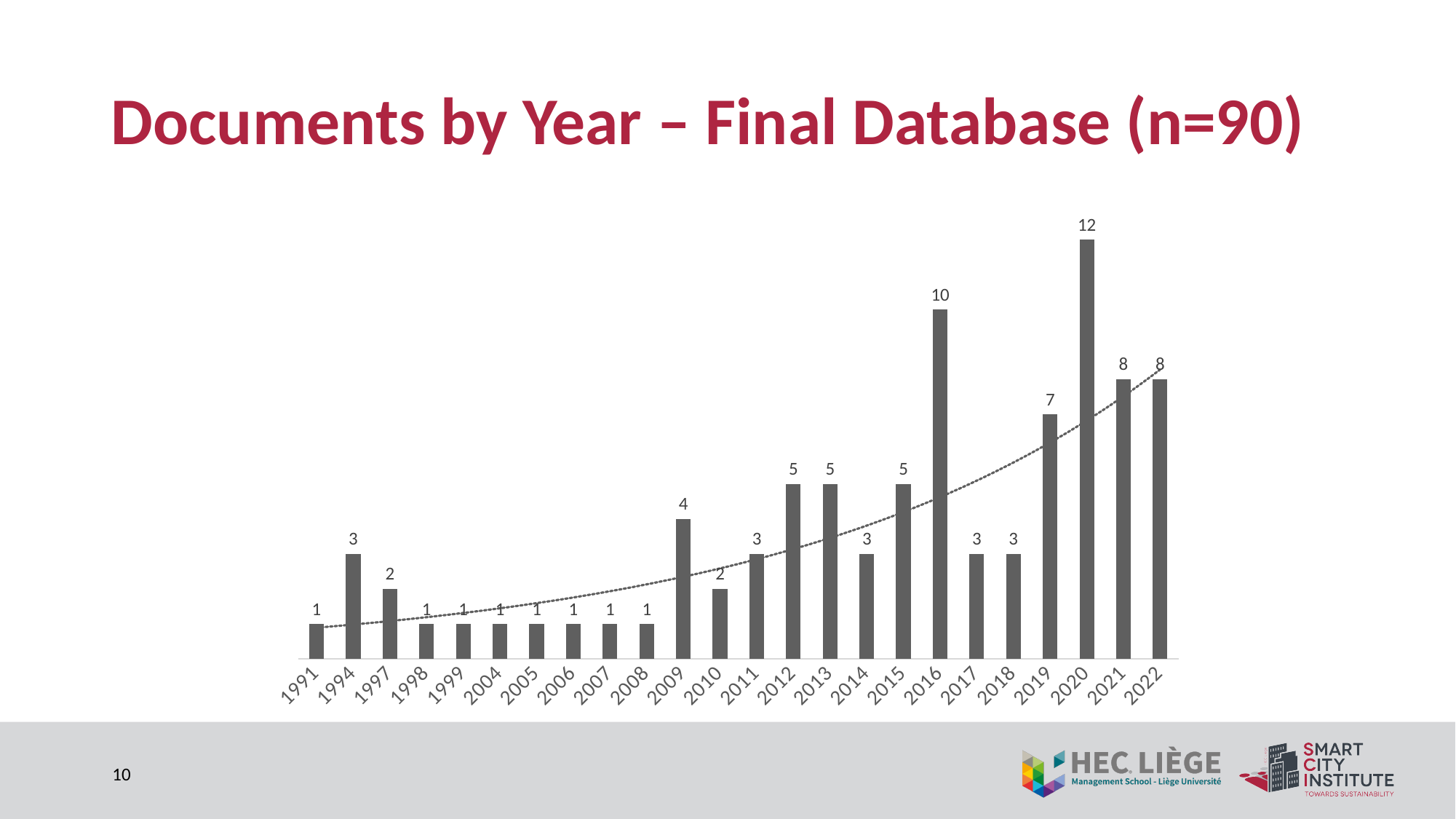
How many documents are shown for 2009? 4 How many years are shown on the x axis? 24 What is the value for 2019? 7 Which is larger, the value for 2012 or the value for 2014? 2012 What is the title of the slide? Documents by Year – Final Database (n=90) How many documents are shown for 2020? 12 What is the lowest value shown on the chart? 1 What is the difference between the values for 2019 and 2018? 4 What is the difference between the values for 2020 and 2016? 2 What is the value for 2016? 10 What kind of chart is shown on the slide? Bar chart Which year has the highest number of documents? 2020